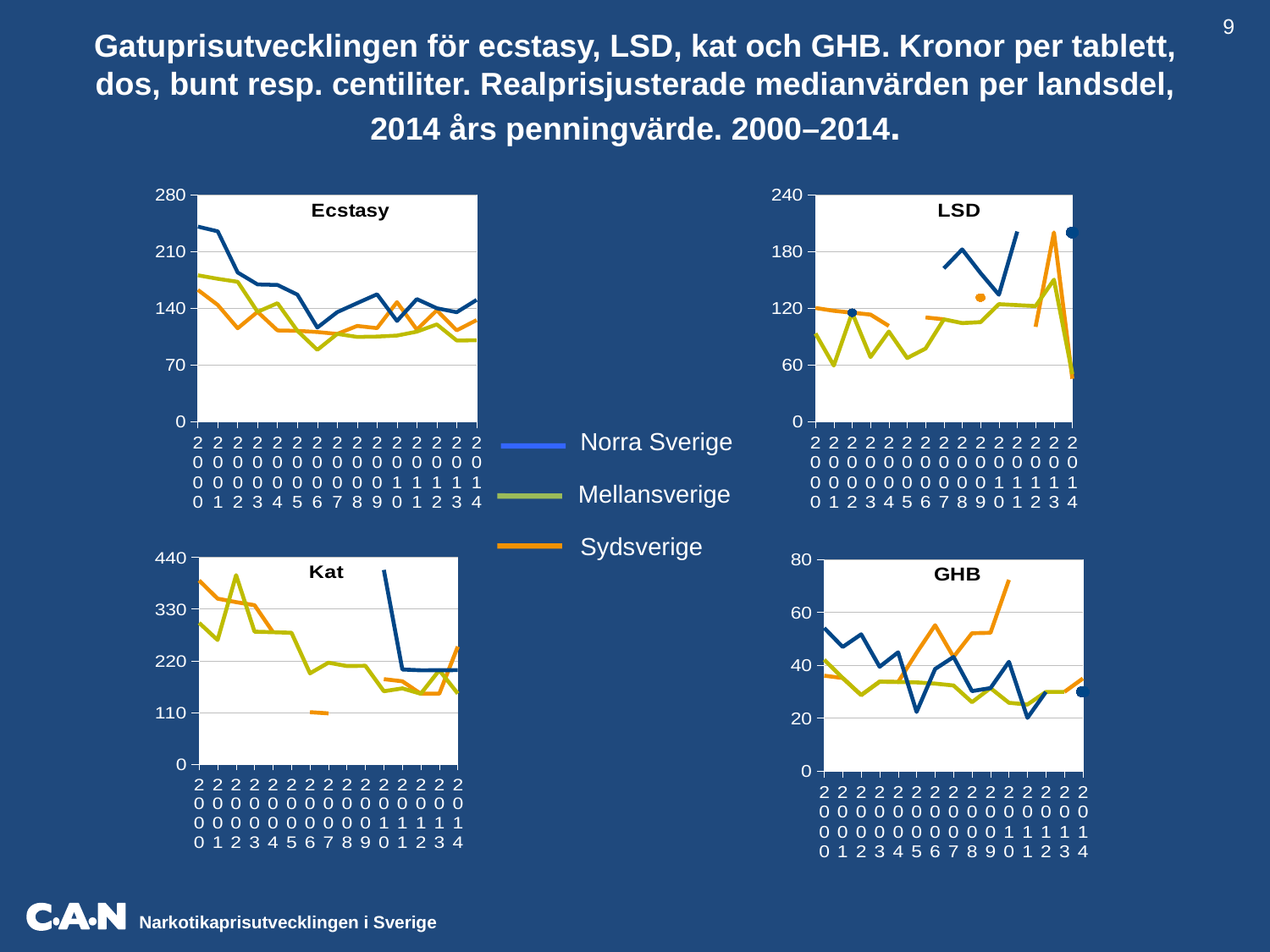
How many charts are shown on the slide? 4 In the Ecstasy chart, is the value for Mellansverige in 2014 greater or less than 140? less What kind of chart is the Ecstasy chart? line chart In the Kat chart, does the Mellansverige line overall rise or fall from 2000 to 2014? fall How many series does the legend list? 3 In the Kat chart, is the value for Sydsverige in 2000 greater or less than 330? greater In the LSD chart, is the value for Mellansverige in 2014 greater or less than 60? less How many years are shown on the x axis of the GHB chart? 15 In the Ecstasy chart, does the Norra Sverige line overall rise or fall from 2000 to 2014? fall Which series is drawn in orange in the legend? Sydsverige